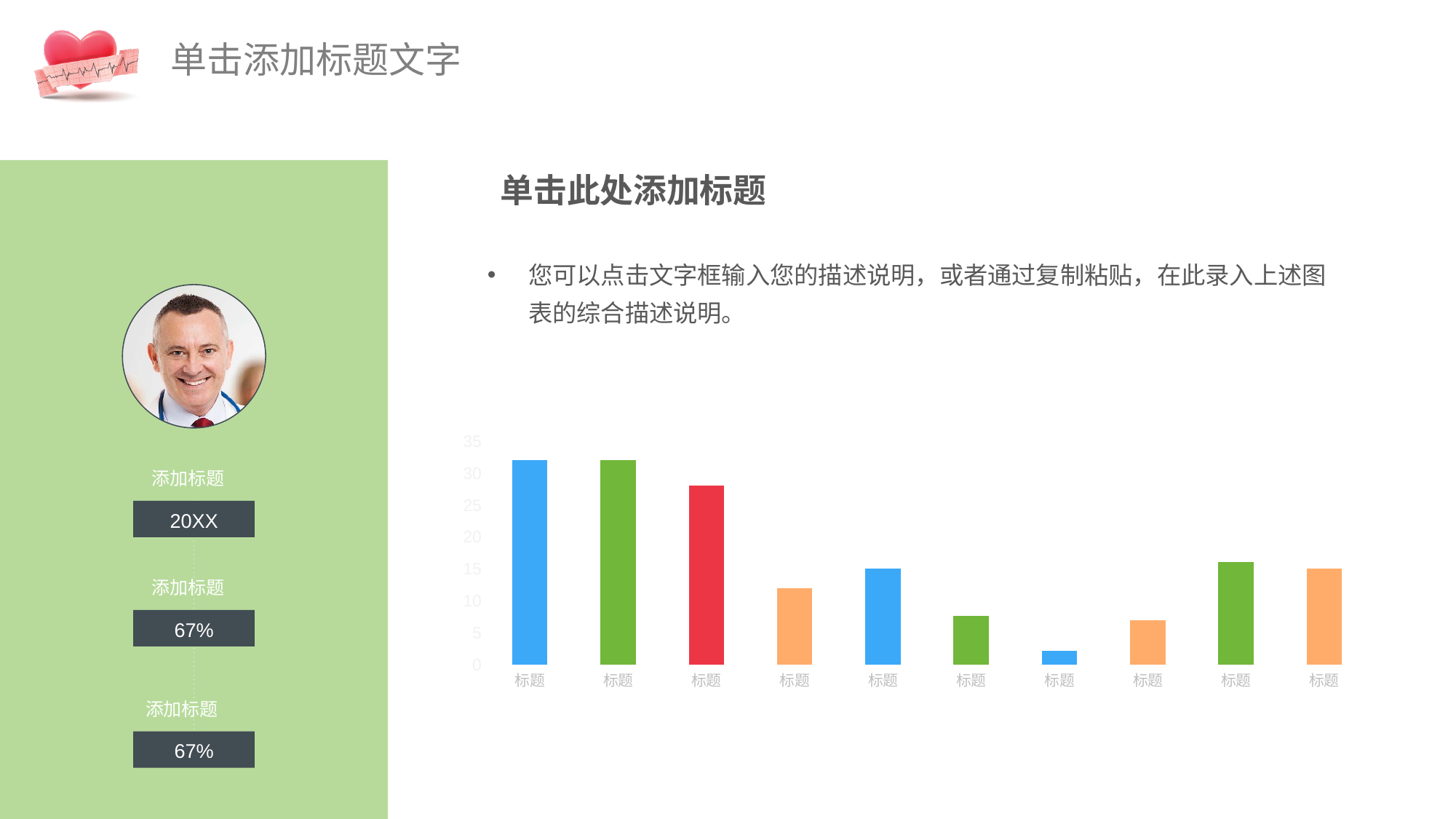
Is the value of the first bar greater or less than 30? greater Which is larger, the sixth bar or the ninth bar? the ninth bar Is the value of the third bar greater or less than 25? greater Which bar is the lowest in the chart? the seventh bar (blue) What kind of chart is shown on the slide? bar chart What label is shown under each bar on the horizontal axis? 标题 Is the value of the fourth bar greater or less than 15? less What is the highest value shown on the vertical axis? 35 Which is larger, the third bar or the fourth bar? the third bar How many bars are plotted in the chart? 10